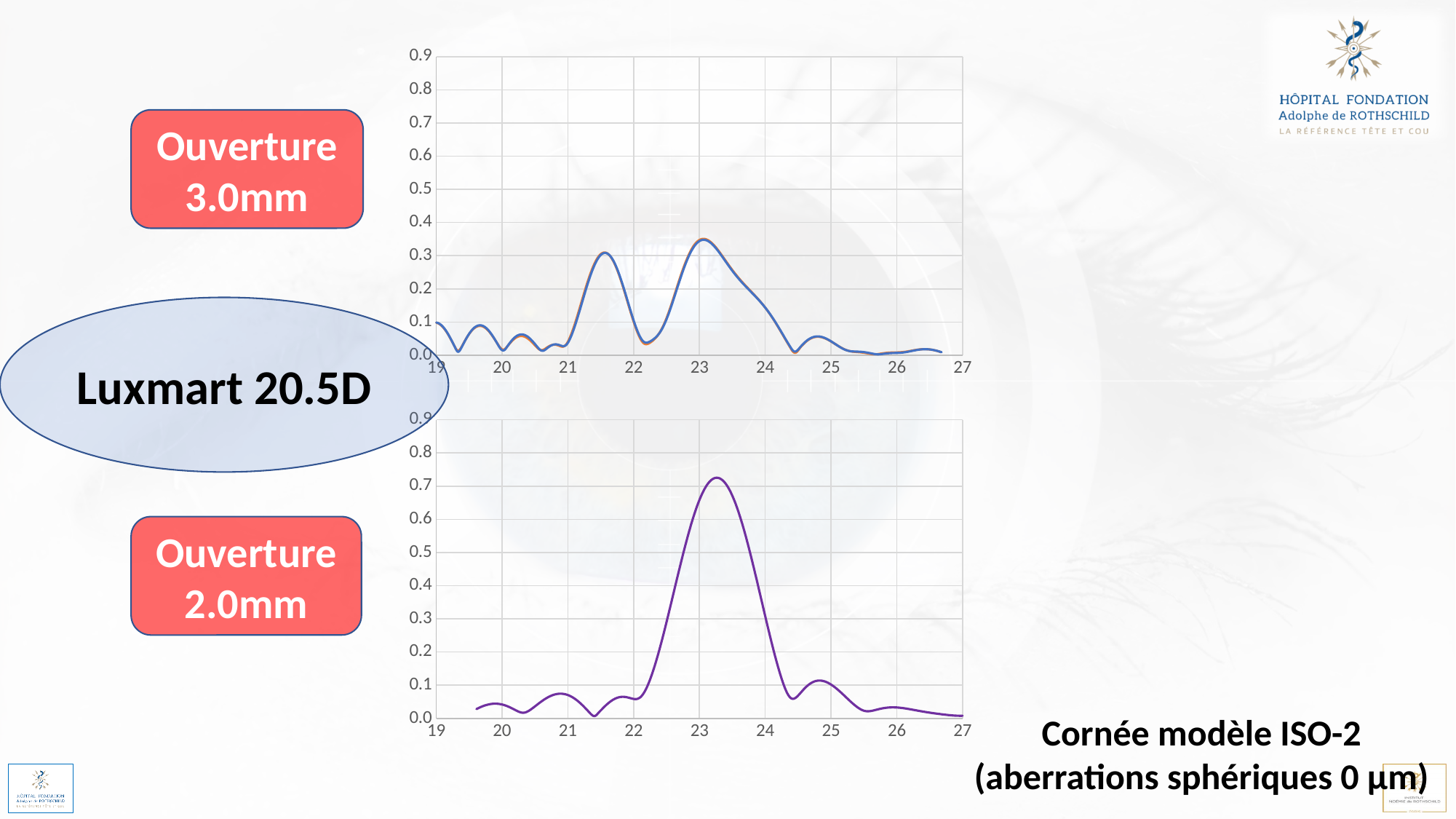
In the bottom chart (Ouverture 2.0mm), is the peak value near x = 23 greater or less than 0.6? greater Which chart reaches the higher maximum value, the top chart (Ouverture 3.0mm) or the bottom chart (Ouverture 2.0mm)? the bottom chart (Ouverture 2.0mm) In the bottom chart (Ouverture 2.0mm), does the line rise or fall between x = 22 and x = 23? rise In the top chart (Ouverture 3.0mm), is the value at x = 22 greater or less than 0.1? less How many labelled tick marks are on the x axis of the bottom chart (Ouverture 2.0mm)? 9 In the bottom chart (Ouverture 2.0mm), is the value at x = 22 greater or less than 0.1? less What is the highest value shown on the y axis of the top chart (Ouverture 3.0mm)? 0.9 What kind of chart is the top chart (Ouverture 3.0mm)? line chart What colour is the line in the bottom chart (Ouverture 2.0mm)? purple In the bottom chart (Ouverture 2.0mm), does the line rise or fall between x = 23.5 and x = 24.5? fall